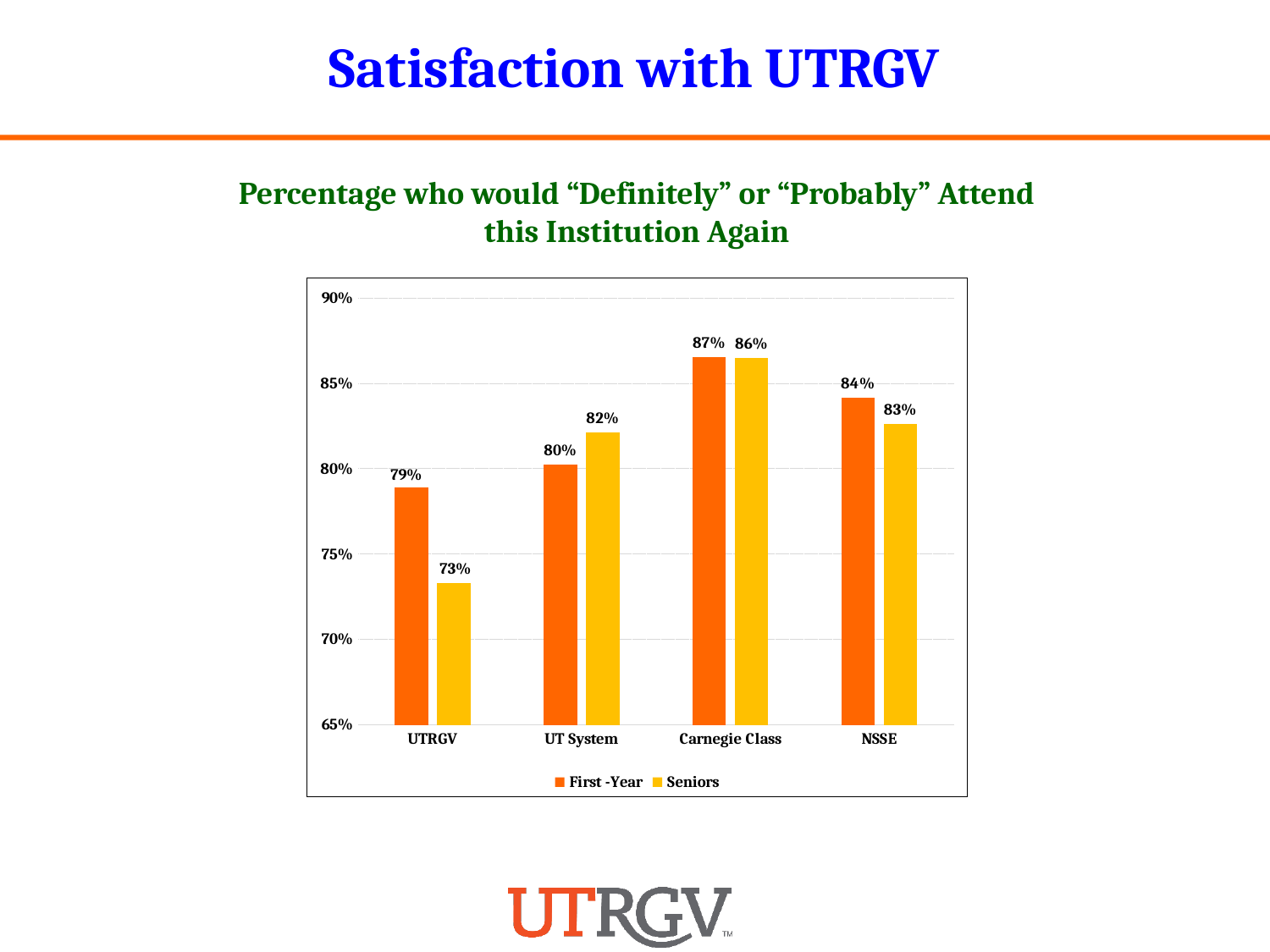
What is the difference between the First-Year and Seniors values for UTRGV? 6% What is the Seniors value for NSSE? 83% What is the First-Year value for UTRGV? 79% What is the Seniors value for UT System? 82% Which category has the lowest Seniors value? UTRGV How many series does the legend list? 2 What kind of chart is shown on the slide? Bar chart Which is larger for UT System, the First-Year value or the Seniors value? Seniors How many categories are shown on the x axis? 4 What is the difference between the Seniors values for Carnegie Class and UT System? 4% What is the title of the chart? Percentage who would "Definitely" or "Probably" Attend this Institution Again Which category has the highest First-Year value? Carnegie Class